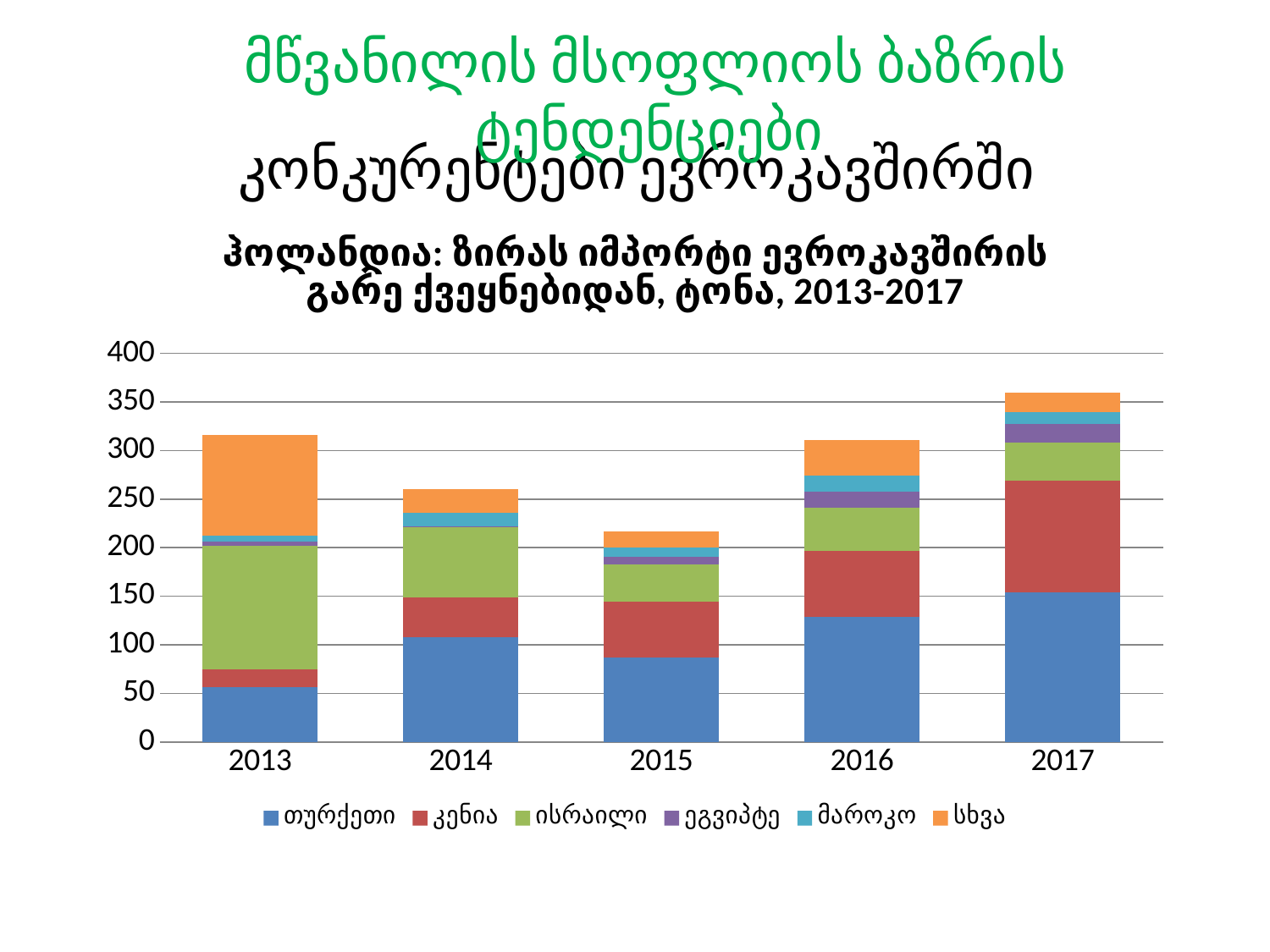
Does the კენია segment rise or fall from 2013 to 2017? rise Which year has the highest total stacked bar? 2017 Which series is listed first in the chart legend? თურქეთი How many years are shown on the x axis of the chart? 5 Is the თურქეთი segment for 2016 greater or less than 100? greater Which year has the largest სხვა segment? 2013 Which year has the lowest total stacked bar? 2015 Is the total for 2015 greater or less than 250? less What kind of chart is shown on the slide? stacked bar chart Is the total for 2017 greater or less than 350? greater How many series does the chart legend list? 6 Which is larger, the თურქეთი segment in 2013 or in 2017? 2017